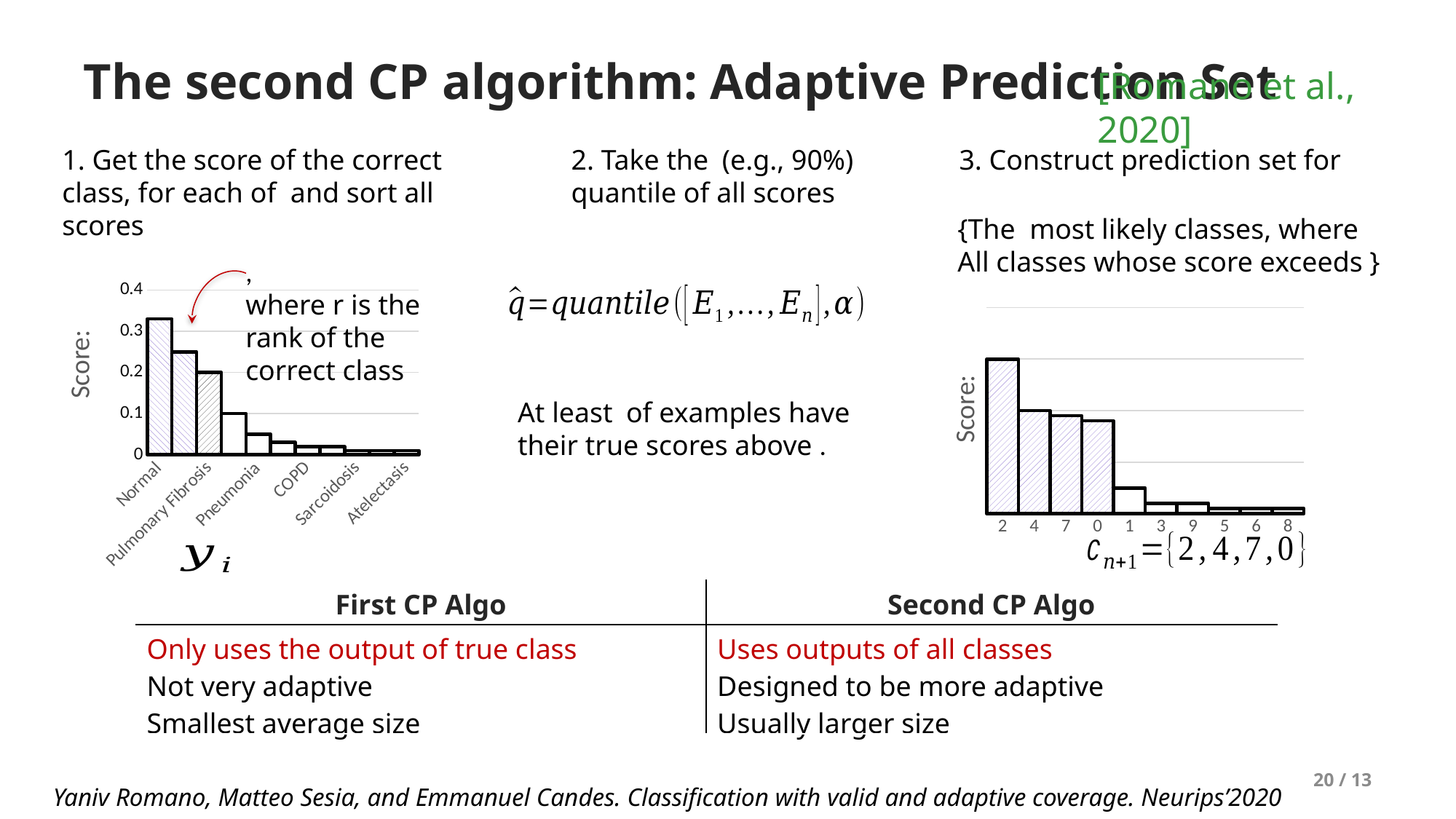
On the right chart, how many categories are shown on the x axis? 10 On the left chart, is the score for Normal greater or less than 0.3? greater On the left chart, which is larger, the score for Normal or the score for Pneumonia? Normal On the right chart, what is the label of the y axis? Score: On the right chart, which category has the highest score? 2 On the left chart, what is the highest value shown on the y axis? 0.4 On the right chart, which is larger, the score for category 2 or the score for category 4? 2 On the left chart, what kind of chart is shown? bar chart On the left chart, do the scores rise or fall from left to right along the x axis? fall On the right chart, do the scores rise or fall from left to right along the x axis? fall On the left chart, which category has the highest score? Normal